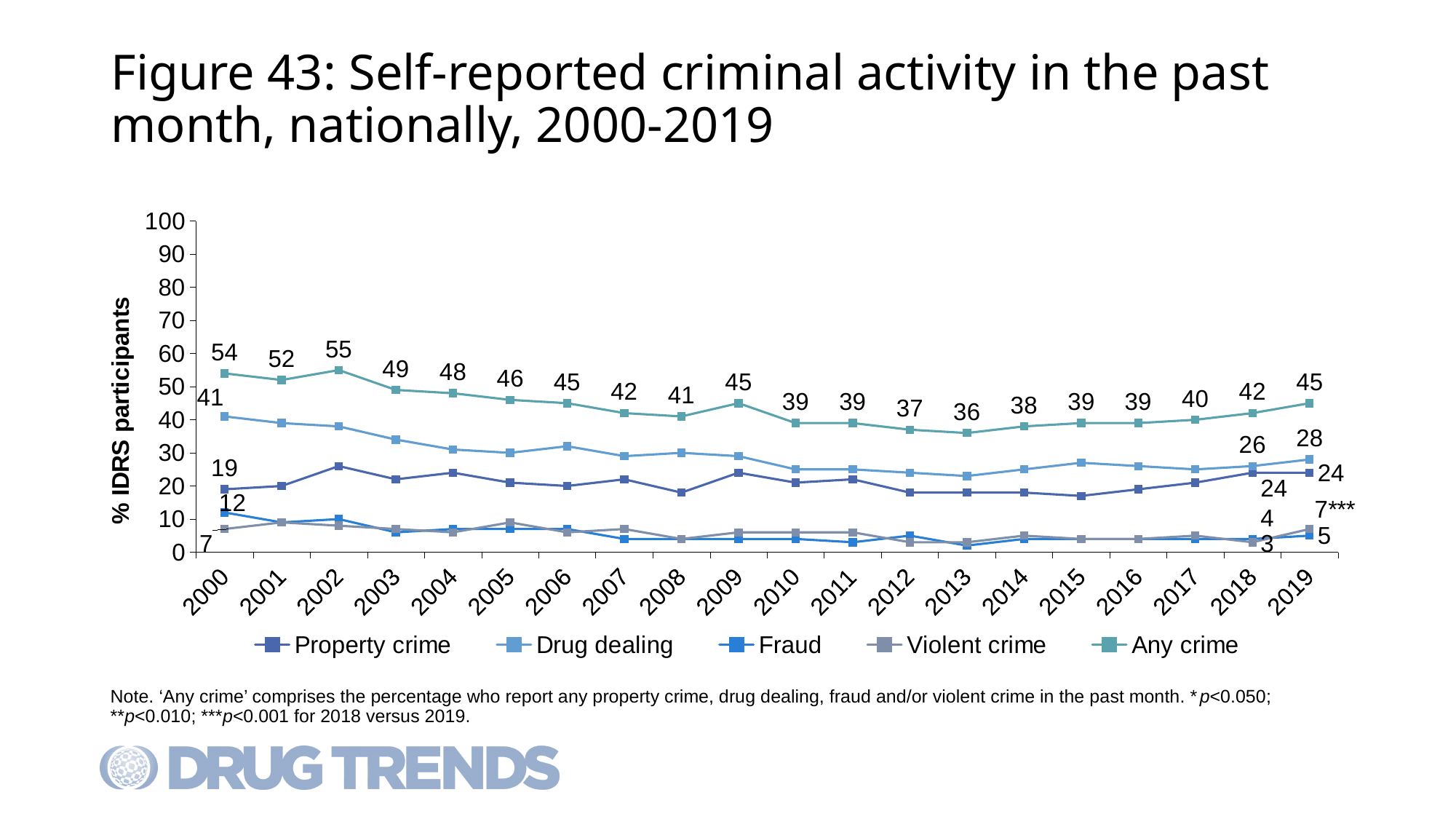
How many series does the legend list? 5 Does the Any crime series rise or fall from 2000 to 2008? fall In 2019, which is larger: Drug dealing or Property crime? Drug dealing What is the value for Fraud in 2000? 12 In which year is the Any crime series at its lowest? 2013 In which year is the Any crime series at its highest? 2002 What is the value for Any crime in 2002? 55 Is the value for Drug dealing in 2010 greater or less than 30? less What is the difference between the Any crime values in 2000 and 2019? 9 What kind of chart is shown on the slide? line chart How many years are plotted on the x axis? 20 What is the value for Drug dealing in 2019? 28